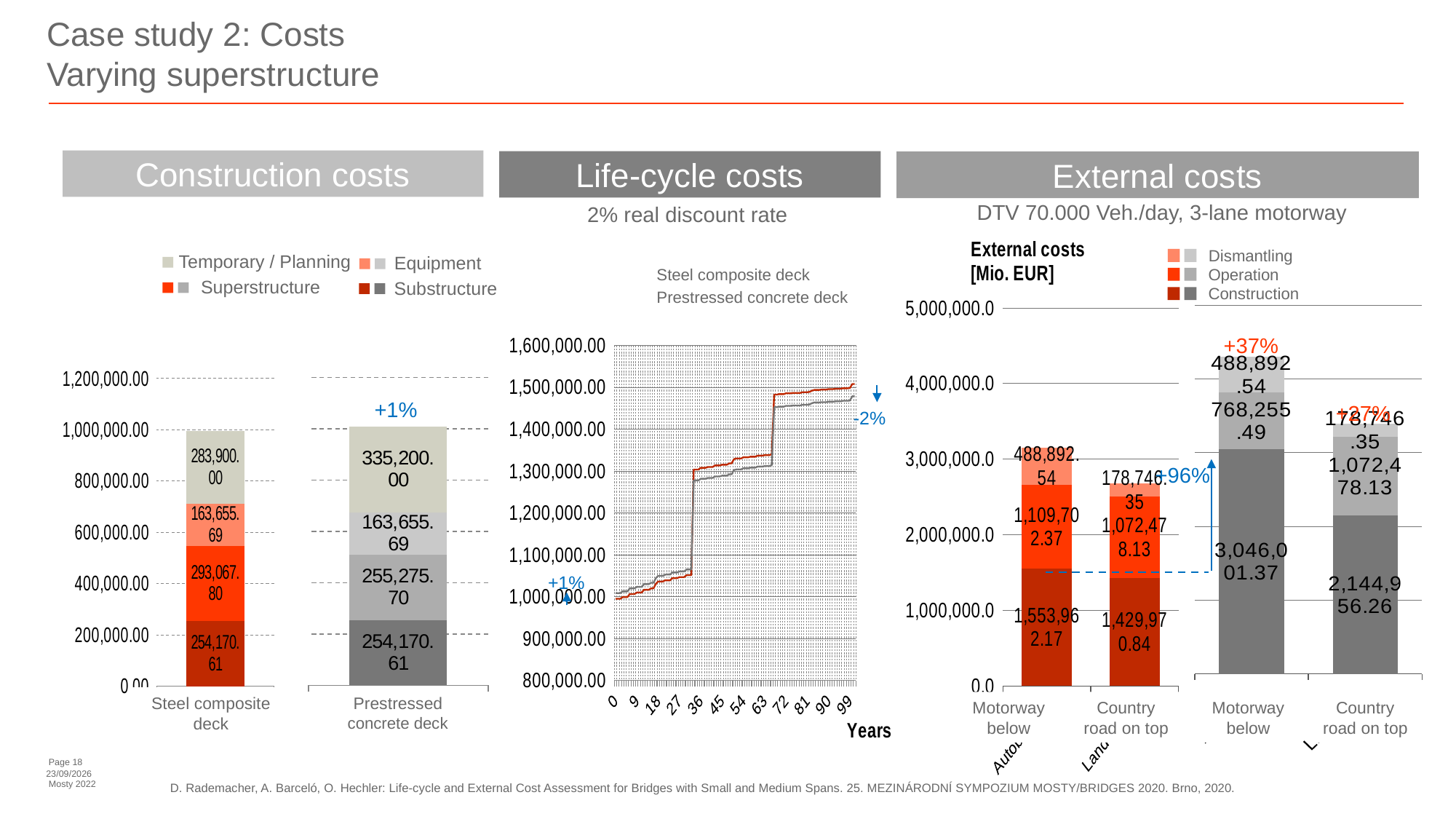
In the Construction costs chart, what is the Substructure value for the Steel composite deck? 254,170.61 In the Construction costs chart, what is the difference between the Superstructure values of the Steel composite deck and the Prestressed concrete deck? 37,792.10 In the Construction costs chart, how many series does the legend list? 4 In the Life-cycle costs chart, do the values rise or fall as the years increase? Rise In the Construction costs chart, what is the total of the Steel composite deck stacked bar? 994,794.10 In the External costs chart, what is the Construction value for the left 'Motorway below' bar? 1,553,962.17 What kind of chart is the Life-cycle costs chart? Line chart In the External costs chart, what is the Dismantling value for the left 'Country road on top' bar? 178,746.35 In the External costs chart, how many series does the legend list? 3 In the Construction costs chart, what is the Temporary / Planning value for the Prestressed concrete deck? 335,200.00 In the Construction costs chart, what is the Superstructure value for the Steel composite deck? 293,067.80 In the Construction costs chart, which deck has the larger Temporary / Planning cost? Prestressed concrete deck